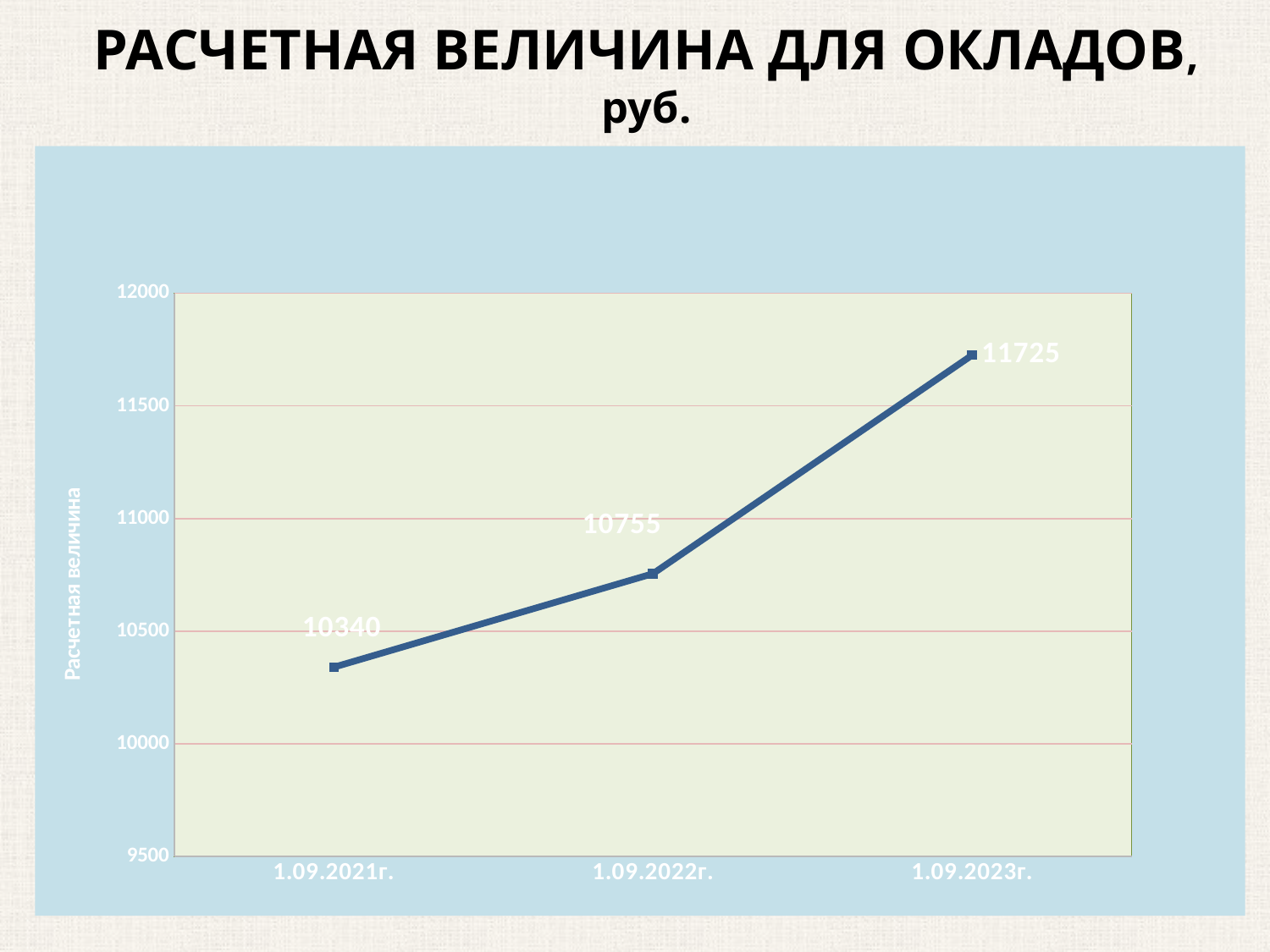
Do the values rise or fall from 1.09.2021г. to 1.09.2023г.? rise What is the value for 1.09.2021г.? 10340 What is the difference between the values for 1.09.2023г. and 1.09.2022г.? 970 Which date has the lowest value? 1.09.2021г. How many data points are plotted on the chart? 3 What is the value for 1.09.2023г.? 11725 Is the value for 1.09.2023г. greater or less than 11500? greater What is the value for 1.09.2022г.? 10755 Which is larger, the value for 1.09.2021г. or the value for 1.09.2022г.? 1.09.2022г. Which date has the highest value? 1.09.2023г. What kind of chart is shown on the slide? line chart What is the difference between the values for 1.09.2022г. and 1.09.2021г.? 415